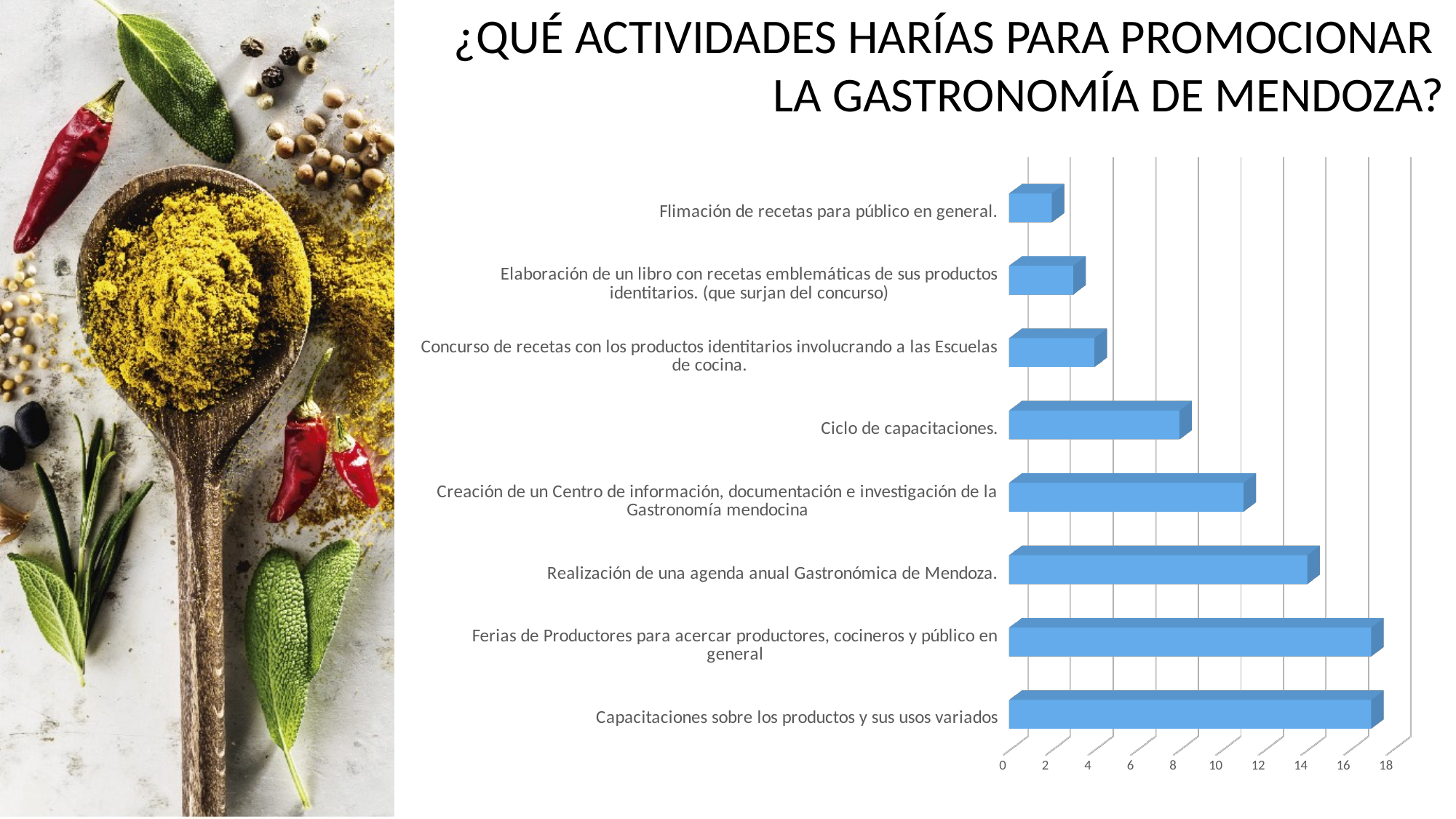
Is the value for "Ferias de Productores para acercar productores, cocineros y público en general" greater or less than 16? greater What kind of chart is shown on the slide? bar chart Which has a larger value: "Realización de una agenda anual Gastronómica de Mendoza." or "Creación de un Centro de información, documentación e investigación de la Gastronomía mendocina"? Realización de una agenda anual Gastronómica de Mendoza. Is the value for "Flimación de recetas para público en general." greater or less than 4? less Which has a larger value: "Ciclo de capacitaciones." or "Concurso de recetas con los productos identitarios involucrando a las Escuelas de cocina."? Ciclo de capacitaciones. Is the value for "Ciclo de capacitaciones." greater or less than 10? less How many categories (activities) are plotted in the chart? 8 What is the highest value shown on the chart's horizontal axis? 18 Which activity has the lowest value in the chart? Flimación de recetas para público en general.